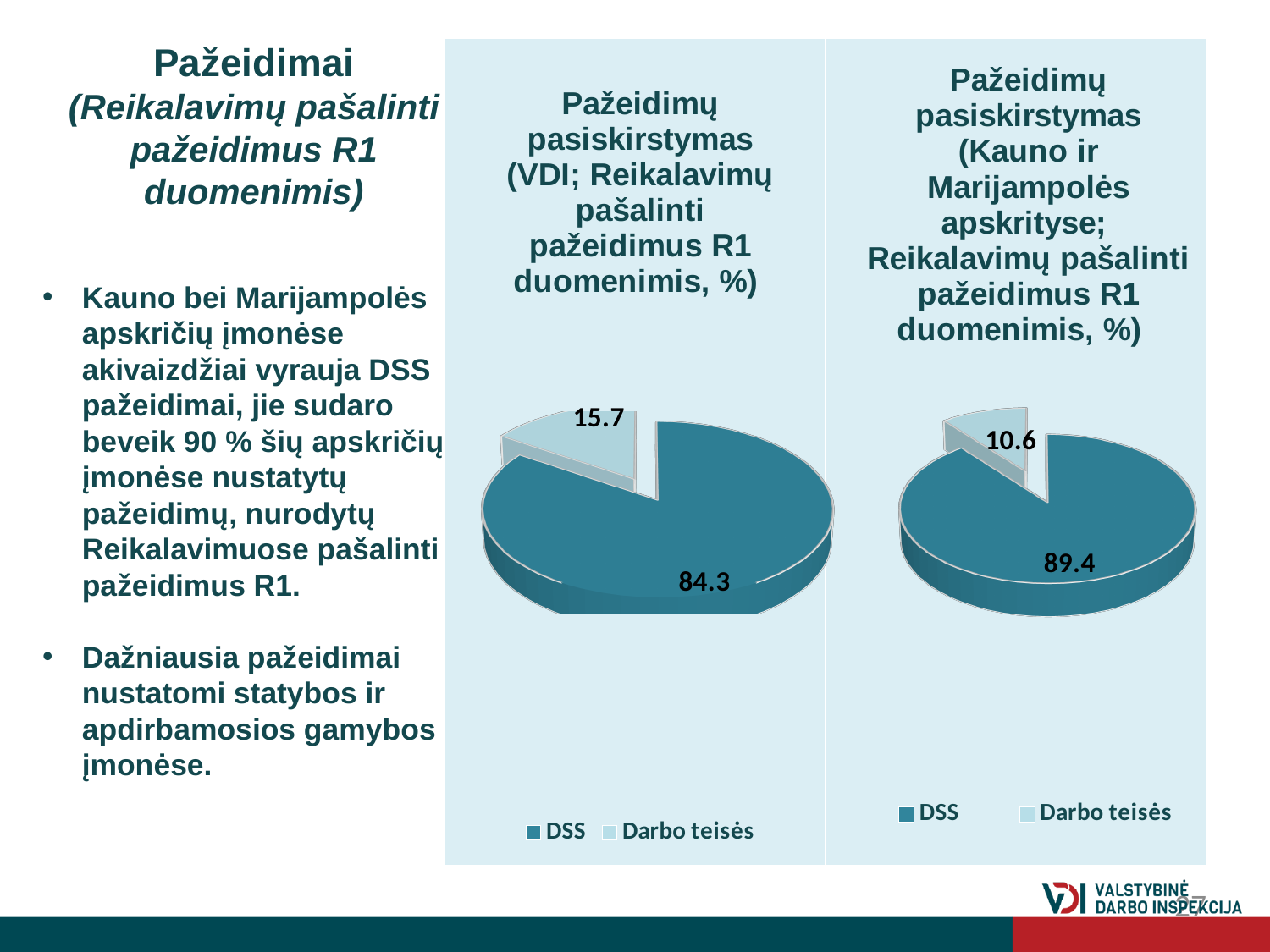
How many categories does the right pie chart (Kauno ir Marijampolės apskrityse) show? 2 In the left pie chart (VDI), what is the value for DSS? 84.3 In the right pie chart (Kauno ir Marijampolės apskrityse), what is the value for Darbo teisės? 10.6 In the right pie chart (Kauno ir Marijampolės apskrityse), what is the value for DSS? 89.4 What type of chart is used on the left side of the slide? Pie chart What are the two legend entries of the left pie chart (VDI)? DSS and Darbo teisės Is the DSS value larger in the left pie chart (VDI) or in the right pie chart (Kauno ir Marijampolės apskrityse)? Right pie chart (89.4) In the right pie chart (Kauno ir Marijampolės apskrityse), which category has the smallest share? Darbo teisės In the left pie chart (VDI), what is the value for Darbo teisės? 15.7 In the left pie chart (VDI), which category has the largest share? DSS In the left pie chart (VDI), what is the difference between the DSS and Darbo teisės values? 68.6 In the right pie chart (Kauno ir Marijampolės apskrityse), what is the difference between the DSS and Darbo teisės values? 78.8